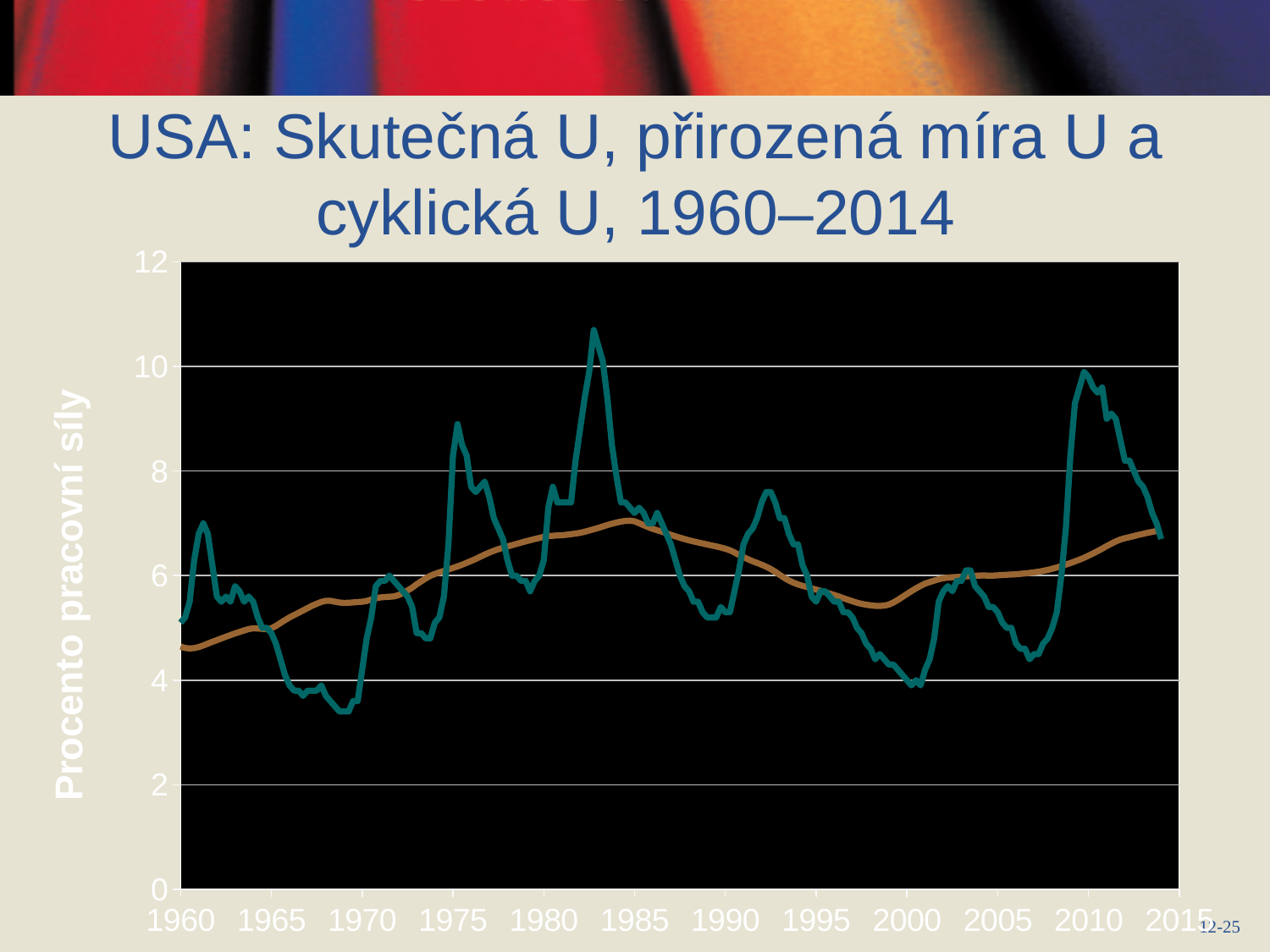
Is the value of the brown line in 1960 greater or less than 6? less Is the value of the brown line around 1985 greater or less than 6? greater Does the brown line rise or fall between 1960 and 1985? rise What type of chart is shown on the slide? line chart What is the title of the chart? USA: Skutečná U, přirozená míra U a cyklická U, 1960–2014 What is the label on the vertical axis of the chart? Procento pracovní síly Is the lowest point of the teal line around 1969 greater or less than 4? less Does the teal line rise or fall between 2010 and 2014? fall How many lines are plotted on the chart? 2